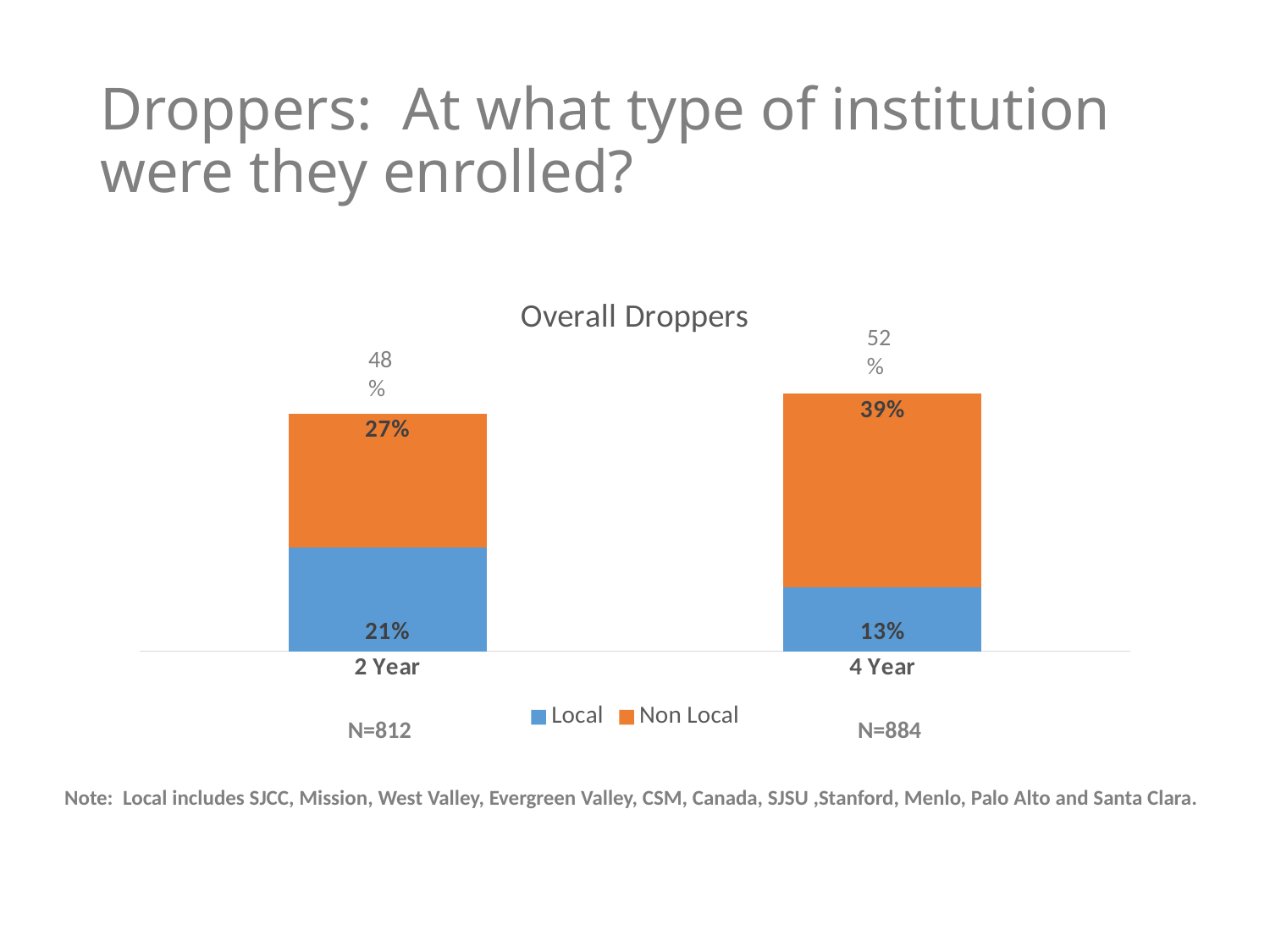
What is the difference between the Non Local values for 4 Year and 2 Year? 12% What is the Local value for 4 Year? 13% What type of chart is shown? Stacked bar chart What is the total of the stacked bar for 2 Year? 48% How many series does the legend list? 2 How many categories are shown on the x axis? 2 What is the total of the stacked bar for 4 Year? 52% What is the Local value for 2 Year? 21% What is the Non Local value for 2 Year? 27% Which category has the highest Non Local value? 4 Year What is the Non Local value for 4 Year? 39% Which category has the higher Local value, 2 Year or 4 Year? 2 Year